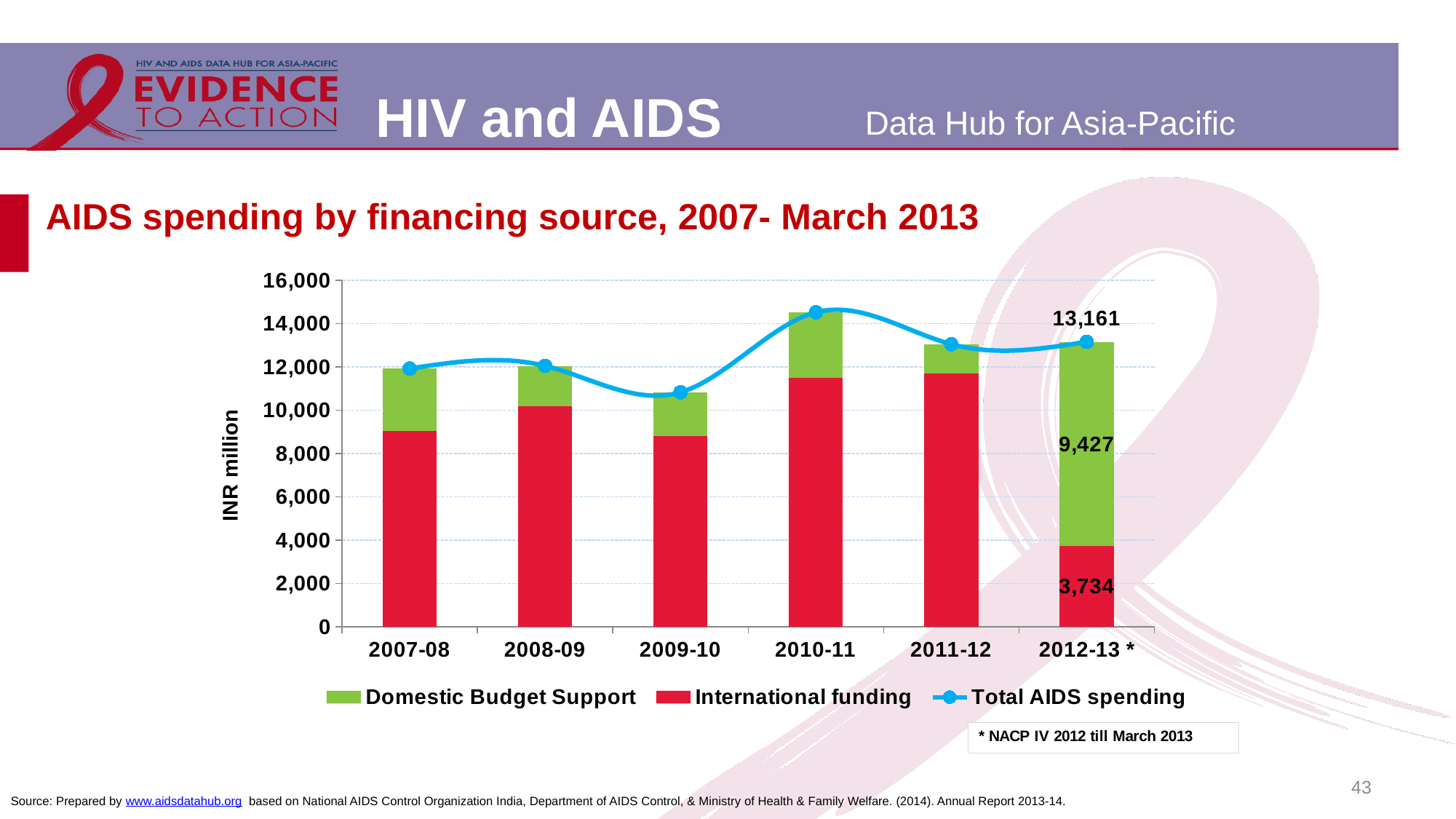
In 2012-13 *, how much larger is Domestic Budget Support than International funding? 5,693 In which year is Total AIDS spending lowest? 2009-10 What unit is shown on the y axis label? INR million In which year is Total AIDS spending highest? 2010-11 Is the International funding value for 2009-10 greater or less than 10,000? less What is the Total AIDS spending for 2012-13 *? 13,161 How many series does the legend list? 3 What is the value of International funding for 2012-13 *? 3,734 In 2012-13 *, which is larger: Domestic Budget Support or International funding? Domestic Budget Support Is the International funding value for 2010-11 greater or less than 10,000? greater How many years are shown on the x axis? 6 What is the value of Domestic Budget Support for 2012-13 *? 9,427